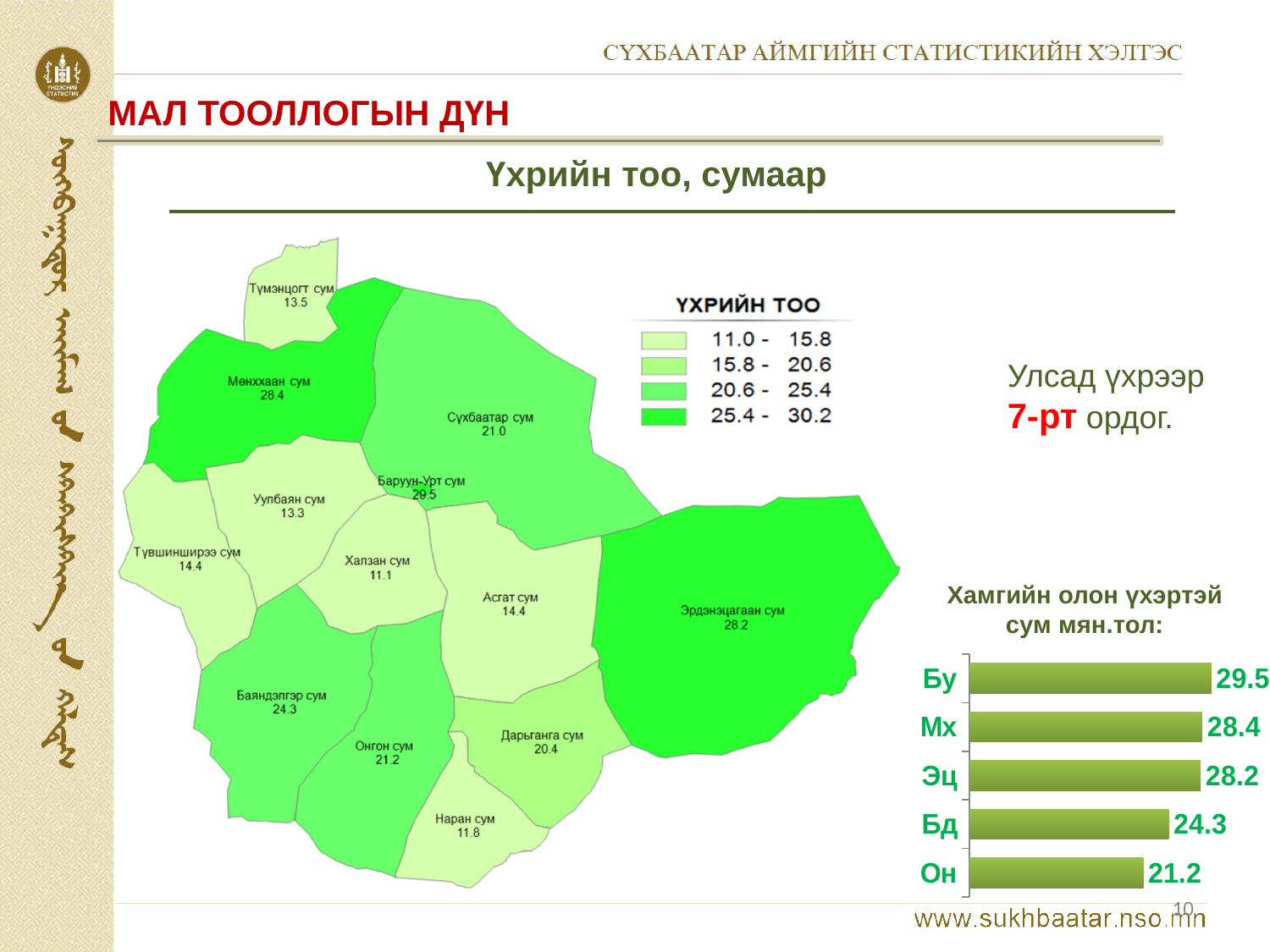
What kind of chart is the one titled "Хамгийн олон үхэртэй сум мян.тол:"? bar chart On the map titled "Үхрийн тоо, сумаар", what value is shown for Халзан сум? 11.1 In the bar chart titled "Хамгийн олон үхэртэй сум мян.тол:", what is the difference between the values for Мх and Эц? 0.2 In the bar chart titled "Хамгийн олон үхэртэй сум мян.тол:", what is the value for Он? 21.2 In the bar chart titled "Хамгийн олон үхэртэй сум мян.тол:", which category has the lowest value? Он How many categories are shown in the bar chart titled "Хамгийн олон үхэртэй сум мян.тол:"? 5 In the bar chart titled "Хамгийн олон үхэртэй сум мян.тол:", what is the value for Бу? 29.5 In the bar chart titled "Хамгийн олон үхэртэй сум мян.тол:", what is the value for Бд? 24.3 In the bar chart titled "Хамгийн олон үхэртэй сум мян.тол:", which category has the highest value? Бу On the map titled "Үхрийн тоо, сумаар", how many value ranges does the legend "ҮХРИЙН ТОО" list? 4 In the bar chart titled "Хамгийн олон үхэртэй сум мян.тол:", what is the difference between the values for Бу and Он? 8.3 In the bar chart titled "Хамгийн олон үхэртэй сум мян.тол:", which is larger, the value for Бд or the value for Он? Бд